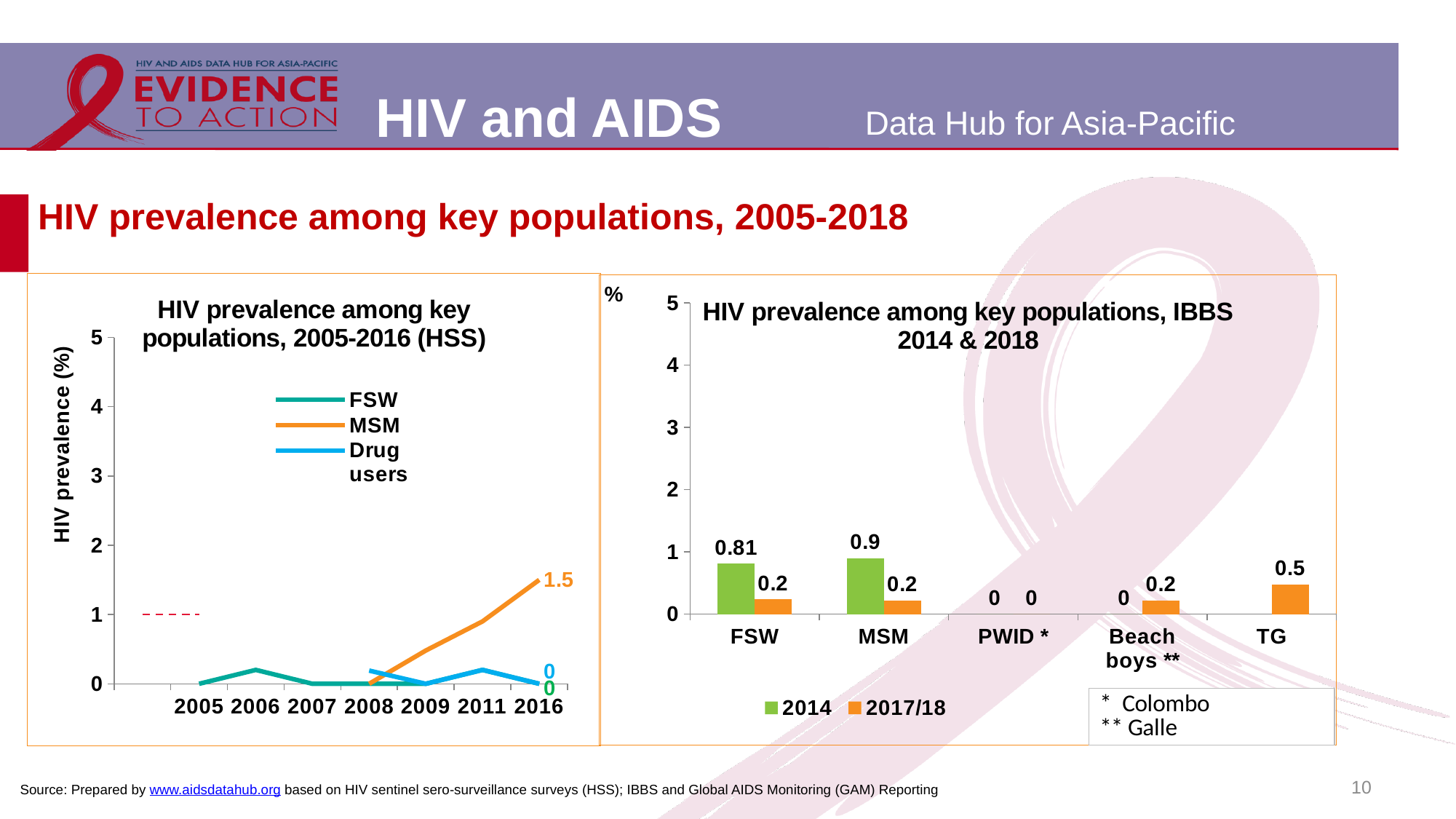
In the chart titled 'HIV prevalence among key populations, IBBS 2014 & 2018', what is the 2017/18 value for TG? 0.5 In the chart titled 'HIV prevalence among key populations, IBBS 2014 & 2018', how many categories are shown on the x axis? 5 In the chart titled 'HIV prevalence among key populations, 2005-2016 (HSS)', what is the MSM value in 2016? 1.5 In the chart titled 'HIV prevalence among key populations, IBBS 2014 & 2018', what is the 2017/18 value for Beach boys? 0.2 In the chart titled 'HIV prevalence among key populations, IBBS 2014 & 2018', what is the 2014 value for FSW? 0.81 In the chart titled 'HIV prevalence among key populations, IBBS 2014 & 2018', how many series does the legend list? 2 In the chart titled 'HIV prevalence among key populations, IBBS 2014 & 2018', which category has the highest 2014 value? MSM In the chart titled 'HIV prevalence among key populations, 2005-2016 (HSS)', how many series does the legend list? 3 What kind of chart is the one titled 'HIV prevalence among key populations, 2005-2016 (HSS)'? line chart In the chart titled 'HIV prevalence among key populations, IBBS 2014 & 2018', what is the 2014 value for MSM? 0.9 In the chart titled 'HIV prevalence among key populations, IBBS 2014 & 2018', what is the difference between the 2014 and 2017/18 values for FSW? 0.61 In the chart titled 'HIV prevalence among key populations, IBBS 2014 & 2018', is the 2017/18 value for TG larger or smaller than the 2017/18 value for MSM? larger